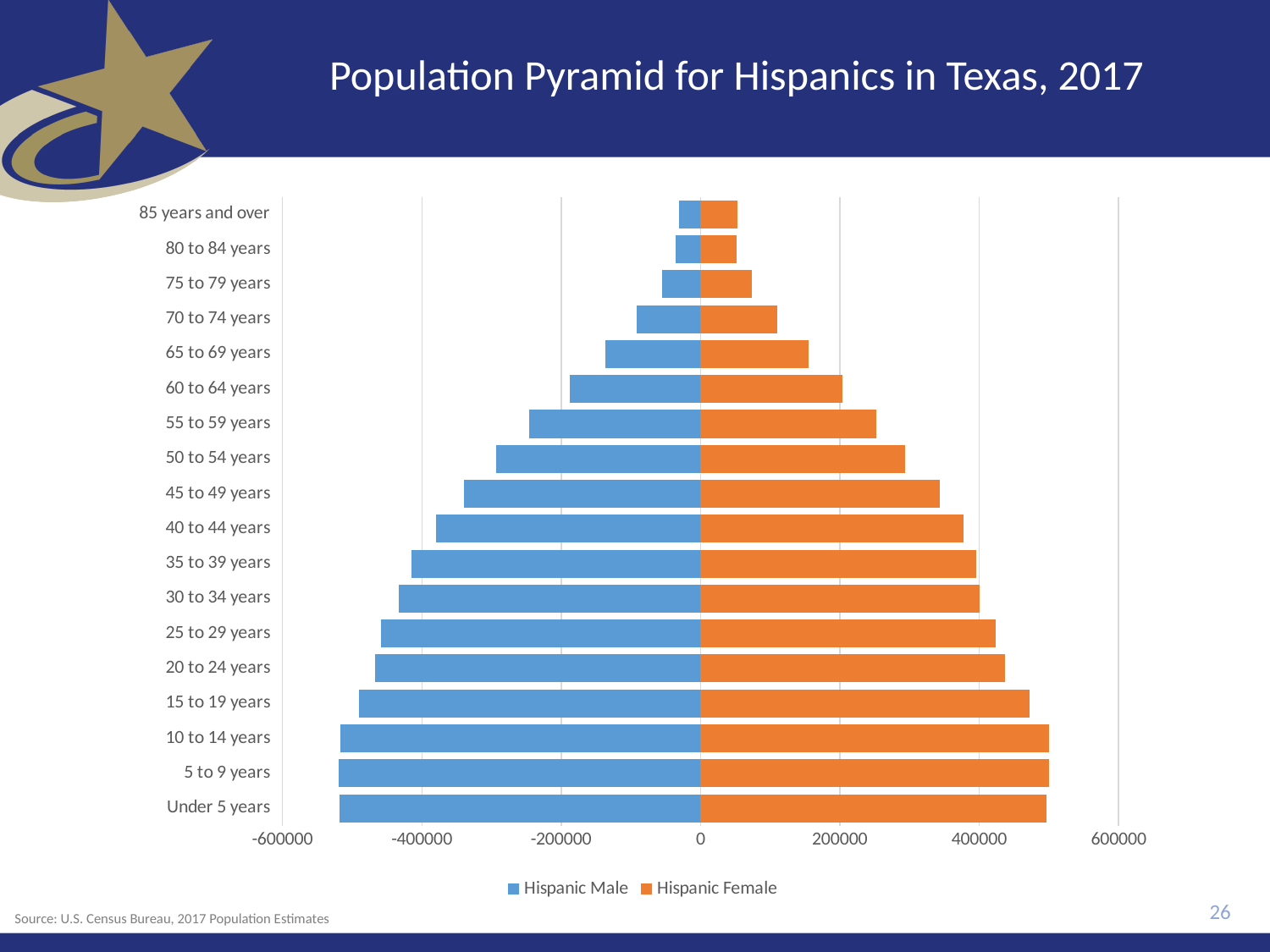
Which series is shown in orange? Hispanic Female How many series does the legend list? 2 What kind of chart is shown on the slide? bar chart How many age group categories are shown on the chart? 18 Is the Hispanic Female value for 10 to 14 years greater or less than 400000? greater What is the title of the chart? Population Pyramid for Hispanics in Texas, 2017 Is the Hispanic Female value for 70 to 74 years greater or less than 200000? less Which age group has the larger Hispanic Female value, 55 to 59 years or 65 to 69 years? 55 to 59 years Is the Hispanic Female value for 65 to 69 years greater or less than 200000? less Which age group has the larger Hispanic Female value, 40 to 44 years or 60 to 64 years? 40 to 44 years Moving from the youngest age group to the oldest, do the bar lengths generally increase or decrease? decrease